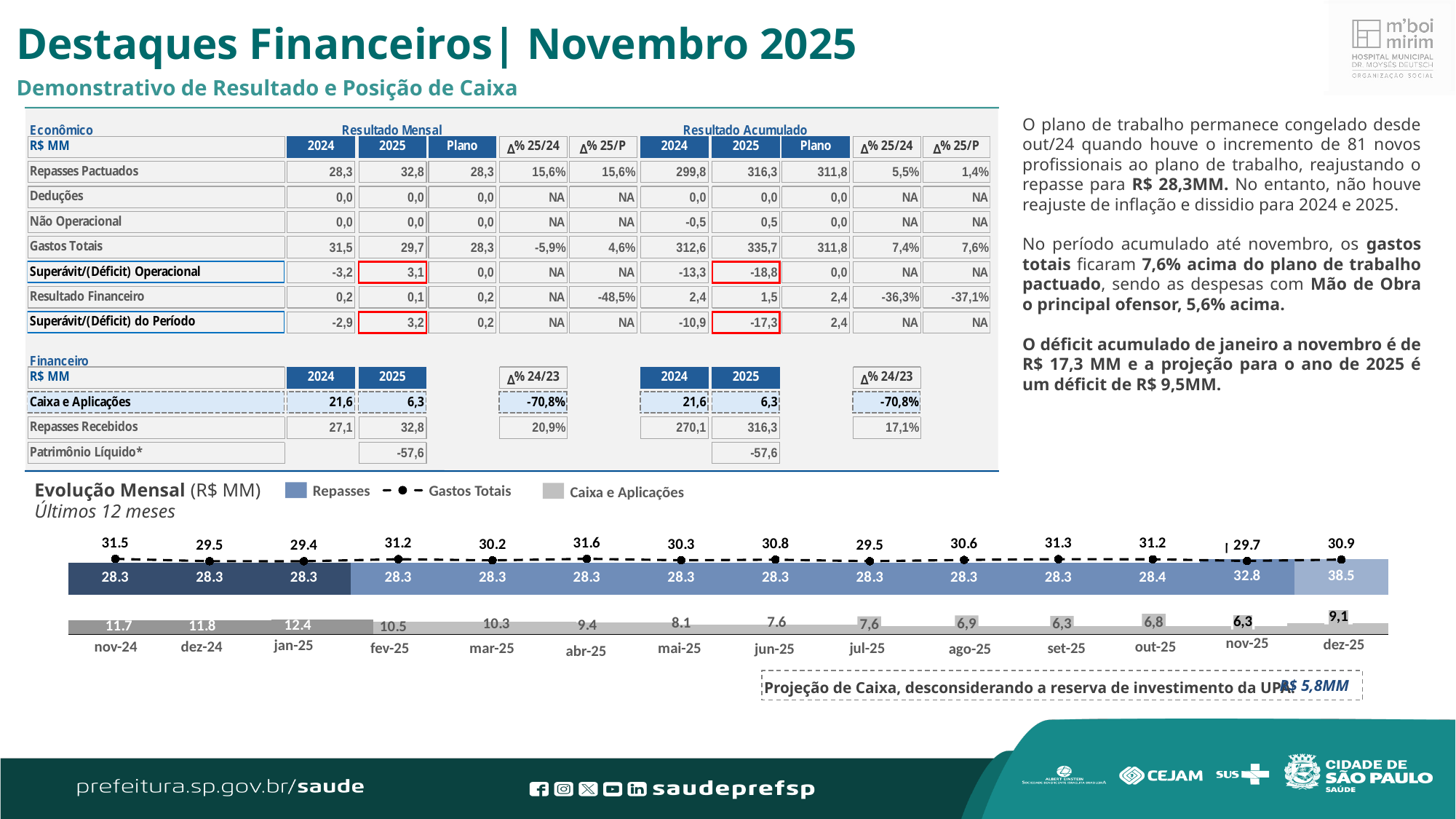
In the Evolução Mensal chart, what is the difference between Gastos Totais and Repasses in nov-24? 3.2 In the Evolução Mensal chart, which month has the highest Caixa e Aplicações value? jan-25 How many months are shown on the x axis of the Evolução Mensal chart? 14 In the Evolução Mensal chart, what is the Gastos Totais value for abr-25? 31.6 In the Evolução Mensal chart, which month has the highest Repasses value? dez-25 In the Evolução Mensal chart, what is the Caixa e Aplicações value for jan-25? 12.4 In the Evolução Mensal chart, do the Caixa e Aplicações values rise or fall from nov-24 to nov-25? fall In the Evolução Mensal chart, what is the Repasses value for dez-25? 38.5 In the Evolução Mensal chart, what is the difference between the Repasses values for dez-25 and nov-25? 5.7 In the Evolução Mensal chart, which month has the larger Gastos Totais value, nov-24 or dez-24? nov-24 In the Evolução Mensal chart, what is the Gastos Totais value for nov-25? 29.7 How many series does the legend of the Evolução Mensal chart list? 3